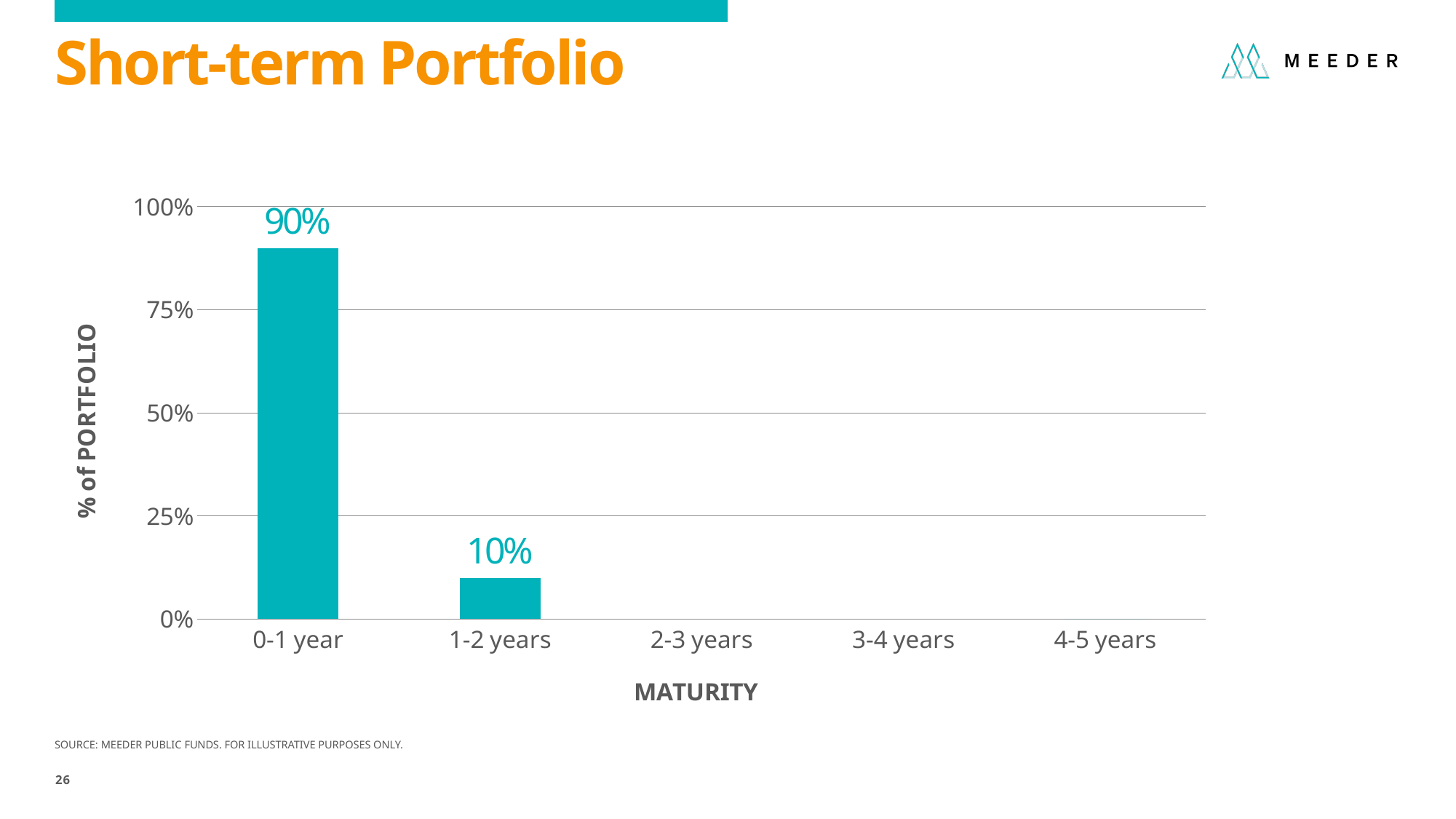
What is the label of the x axis? MATURITY What is the label of the y axis? % of PORTFOLIO How many maturity categories are shown on the x axis? 5 What is the value for the 0-1 year maturity bucket? 90% Which is larger, the value for 0-1 year or the value for 1-2 years? 0-1 year What is the difference between the 0-1 year and 1-2 years values? 80% What kind of chart is shown on the slide? Bar chart Do the values rise or fall moving from 0-1 year to 1-2 years? Fall Is the value for 1-2 years greater or less than 25%? less What is the value for the 1-2 years maturity bucket? 10% Which maturity bucket has the highest share of the portfolio? 0-1 year Is the value for 0-1 year greater or less than 75%? greater